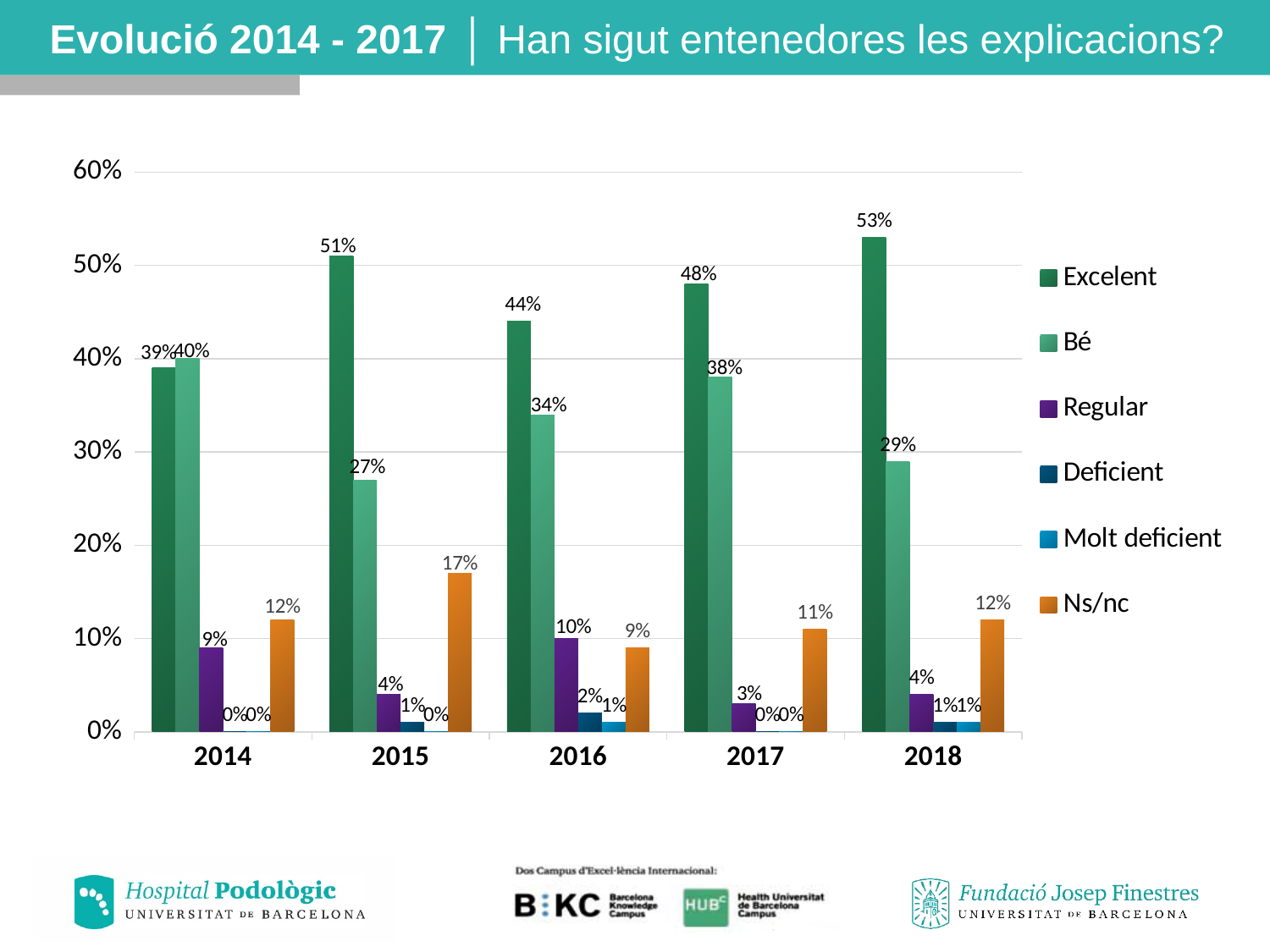
Is the value for Excelent in 2015 greater or less than 50%? greater What is the value for Bé in 2015? 27% How many years are shown on the x axis? 5 Which is larger in 2014, Excelent or Bé? Bé What is the value for Regular in 2014? 9% In which year is the Bé value lowest? 2015 In which year is the Excelent value highest? 2018 What is the difference between the Excelent value in 2018 and the Excelent value in 2014? 14% What is the value for Excelent in 2018? 53% What is the value for Ns/nc in 2016? 9% How many series does the legend list? 6 What kind of chart is shown on the slide? Bar chart